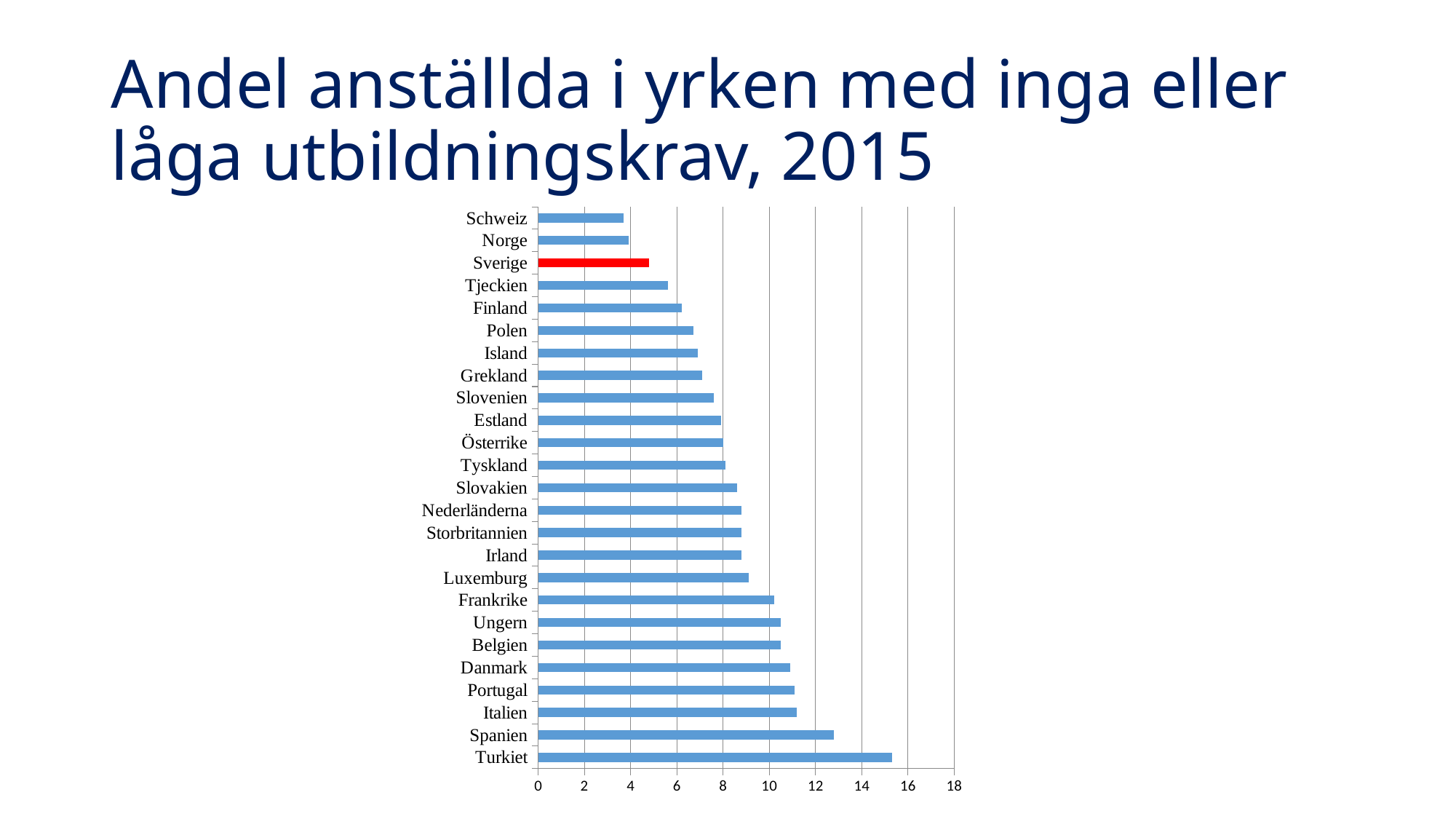
Which has the larger value, Sverige or Norge? Sverige Which country's bar is coloured red in the chart? Sverige Which has the larger value, Danmark or Finland? Danmark How many countries are shown in the chart? 25 Is the value for Schweiz greater or less than 4? less Is the value for Luxemburg greater or less than 8? greater Is the value for Italien greater or less than 12? less What kind of chart is shown on the slide? bar chart Which country has the highest value in the chart? Turkiet